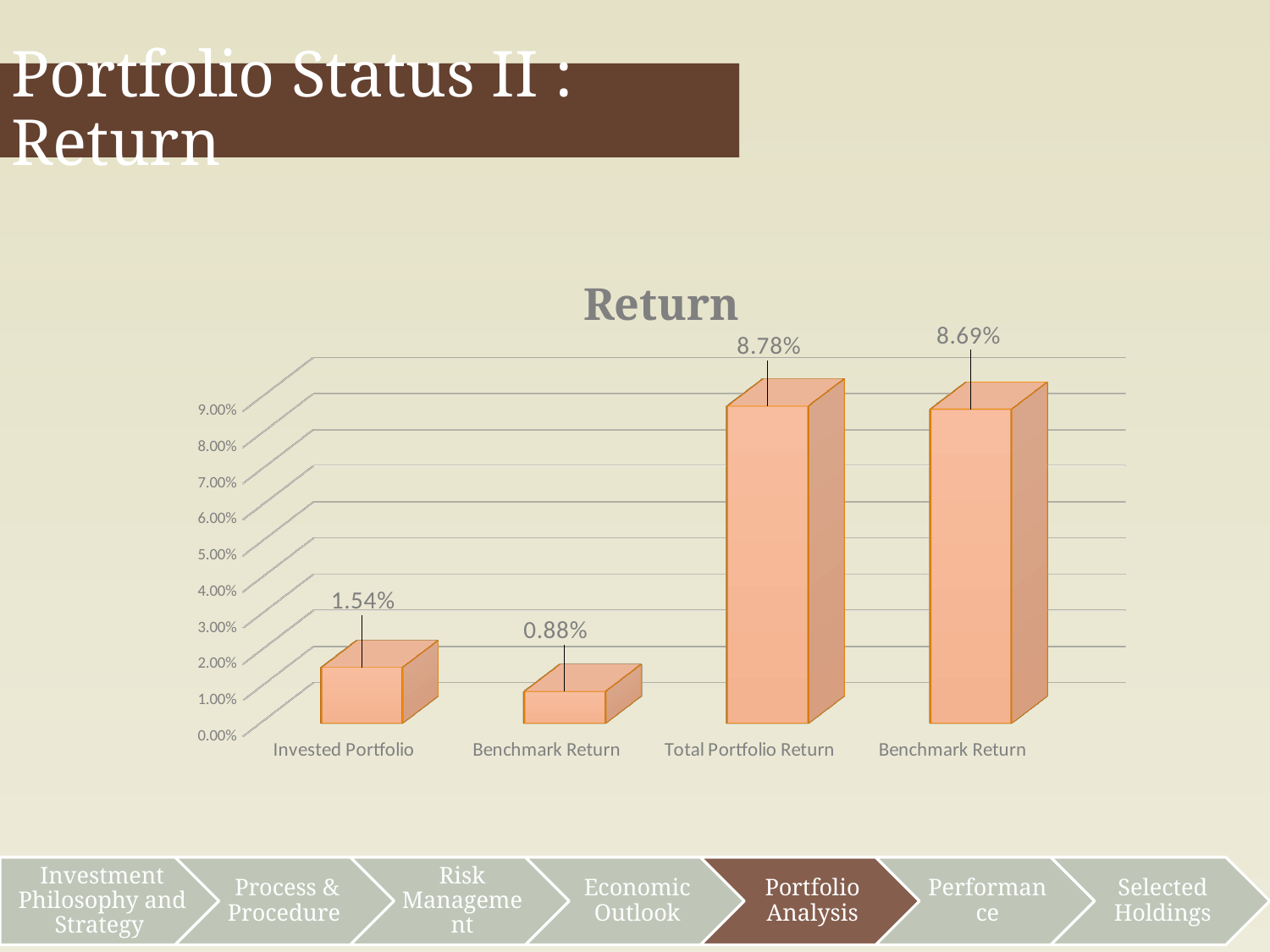
Which is larger in the Return chart: Invested Portfolio or Total Portfolio Return? Total Portfolio Return How many bars are shown in the Return chart? 4 What type of chart is shown on the slide? Bar chart Which bar has the lowest value in the Return chart? The second bar, Benchmark Return (0.88%) What is the value of the rightmost bar (the second Benchmark Return bar) in the Return chart? 8.69% What is the value of the second bar from the left (the first Benchmark Return bar) in the Return chart? 0.88% Which category has the highest value in the Return chart? Total Portfolio Return What is the difference between Total Portfolio Return and the Benchmark Return bar next to it in the Return chart? 0.09% What is the difference between Invested Portfolio and the Benchmark Return bar next to it in the Return chart? 0.66% What is the value for Total Portfolio Return in the Return chart? 8.78% What is the title of the chart on the slide? Return What is the value for Invested Portfolio in the Return chart? 1.54%